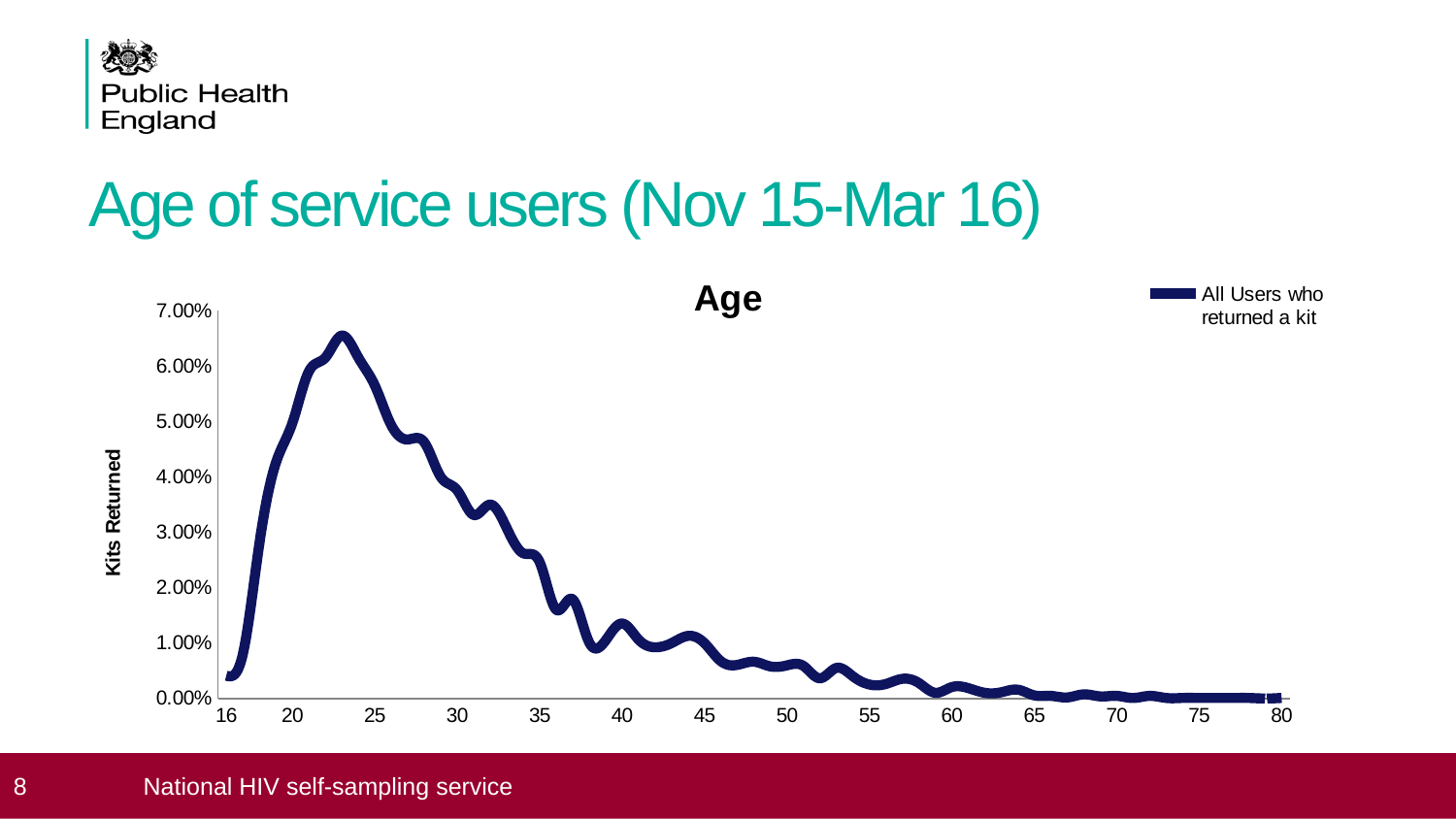
How many series does the legend list? 1 Do the values rise or fall along the x axis from age 25 to age 80? fall Is the value for age 23 greater or less than 6.00%? greater Which has the larger value, age 30 or age 50? age 30 Is the value for age 16 greater or less than 1.00%? less What kind of chart is shown on the slide? line chart Is the value for age 30 greater or less than 3.00%? greater What is the label on the y axis of the chart? Kits Returned What is the title of the chart? Age Which has the larger value, age 20 or age 40? age 20